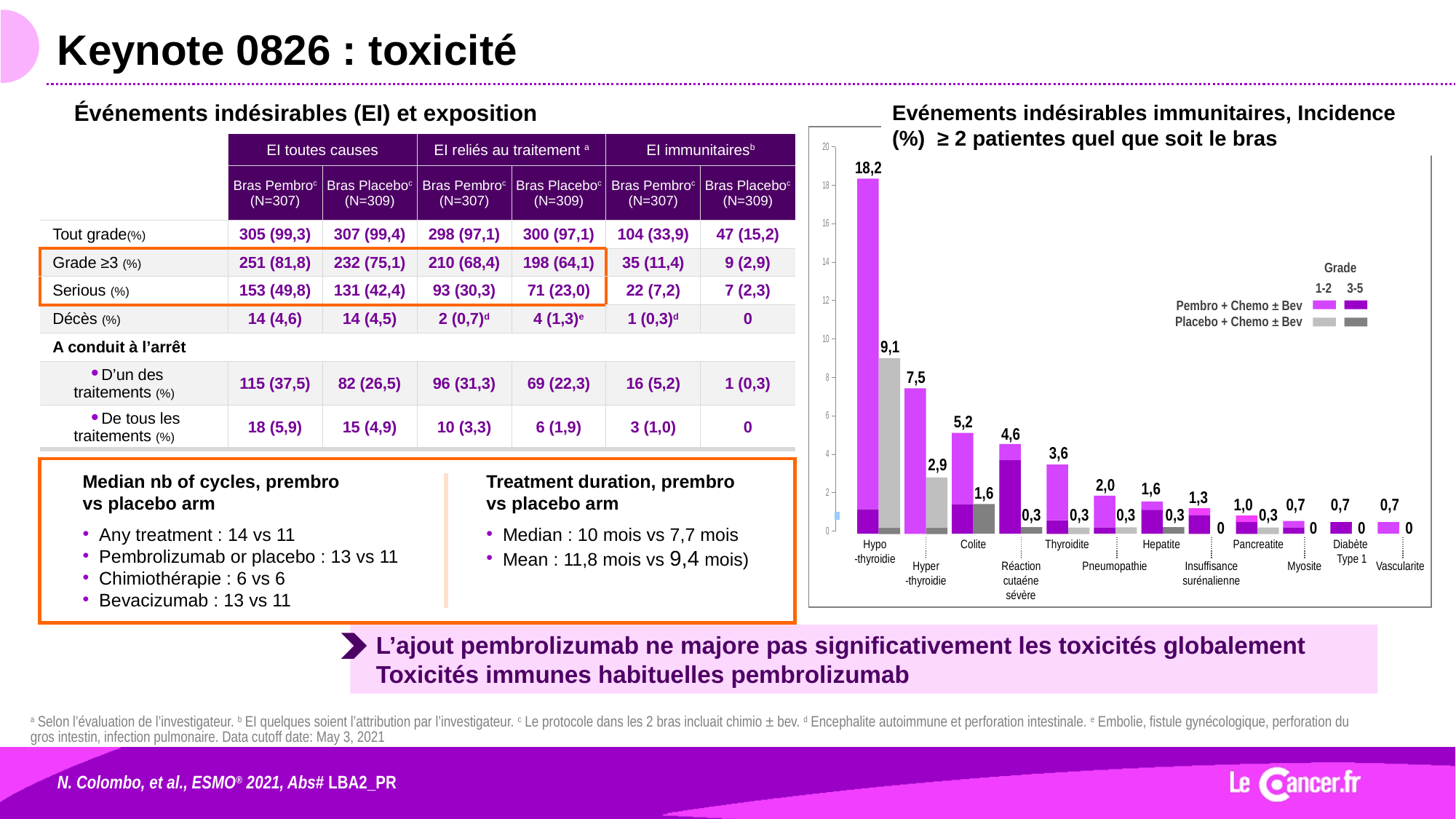
What is the incidence (%) of hypothyroidie in the Pembro + Chemo ± Bev arm? 18,2 What is the difference in hyperthyroidie incidence between the Pembro arm (7,5) and the Placebo arm (2,9)? 4,6 Which immune-mediated adverse event has the highest incidence in the Pembro + Chemo ± Bev arm? Hypothyroidie In the Pembro + Chemo ± Bev arm, which has the higher incidence: colite or thyroidite? Colite What is the difference in hypothyroidie incidence between the Pembro arm (18,2) and the Placebo arm (9,1)? 9,1 Do the Pembro + Chemo ± Bev incidence values rise or fall moving from left to right along the x axis? Fall What is the incidence (%) of colite in the Placebo + Chemo ± Bev arm? 1,6 What kind of chart is used to show the incidence of immune-mediated adverse events? Bar chart What is the incidence (%) of insuffisance surrénalienne in the Placebo + Chemo ± Bev arm? 0 What is the incidence (%) of pneumopathie in the Pembro + Chemo ± Bev arm? 2,0 How many immune-mediated adverse event categories are shown on the x axis of the chart? 12 What is the incidence (%) of hypothyroidie in the Placebo + Chemo ± Bev arm? 9,1